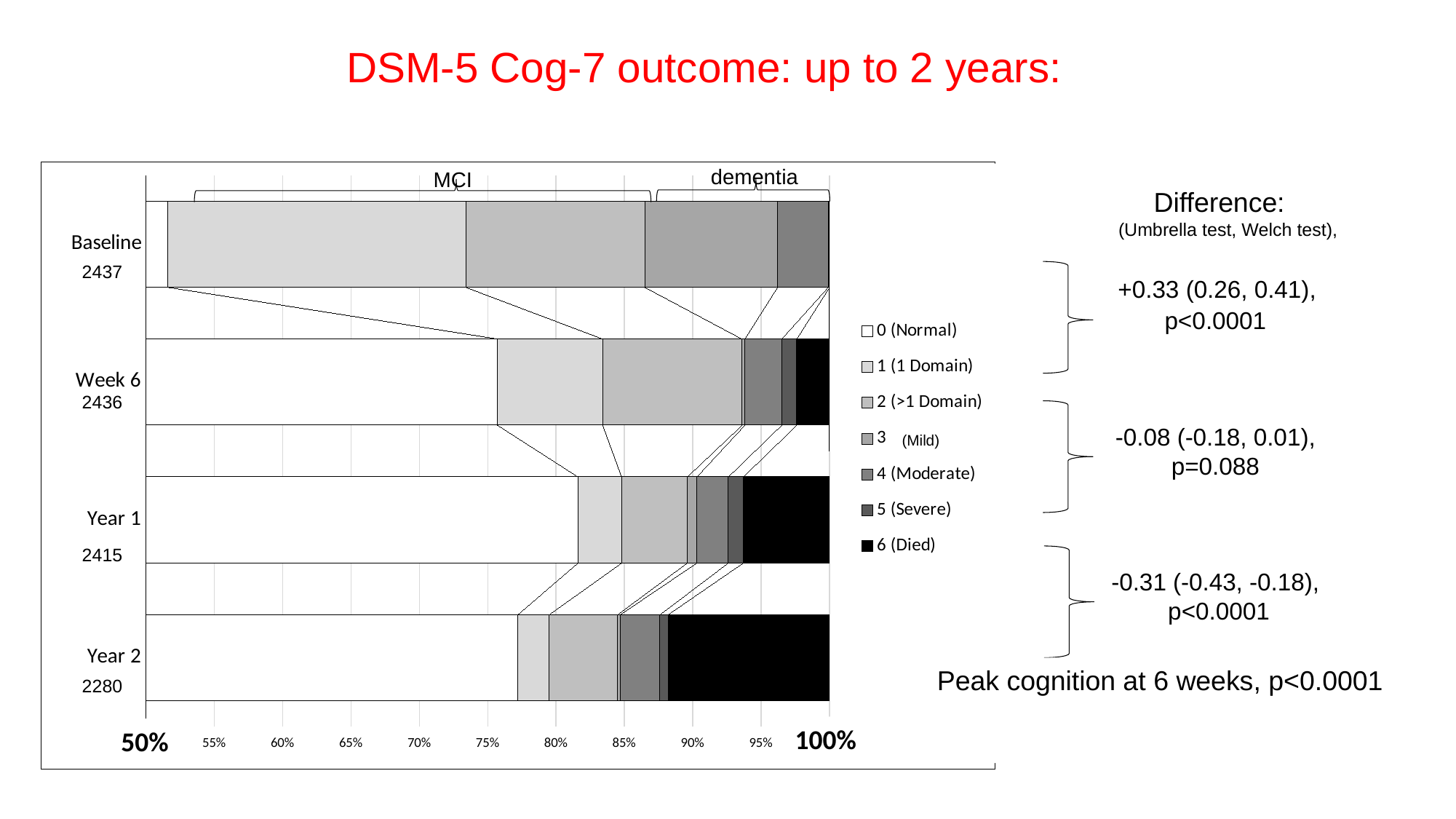
Going from Baseline to Year 2, does the '6 (Died)' segment grow or shrink? Grow How many series does the chart legend list? 7 What sample size is printed under the Year 2 label on the chart? 2280 Is the '1 (1 Domain)' segment wider at Baseline or at Week 6? Baseline Which time point has the largest '1 (1 Domain)' segment? Baseline Does the black '6 (Died)' segment for Year 2 begin at a value greater or less than 85%? greater Is the '6 (Died)' segment larger at Year 1 or at Year 2? Year 2 What is the title of the slide containing the chart? DSM-5 Cog-7 outcome: up to 2 years: How many time points (categories) are plotted on the chart? 4 What kind of chart is shown on the slide? Stacked horizontal bar chart Does the '1 (1 Domain)' segment for Baseline begin at a value greater or less than 55%? less Which time point has the largest black '6 (Died)' segment? Year 2